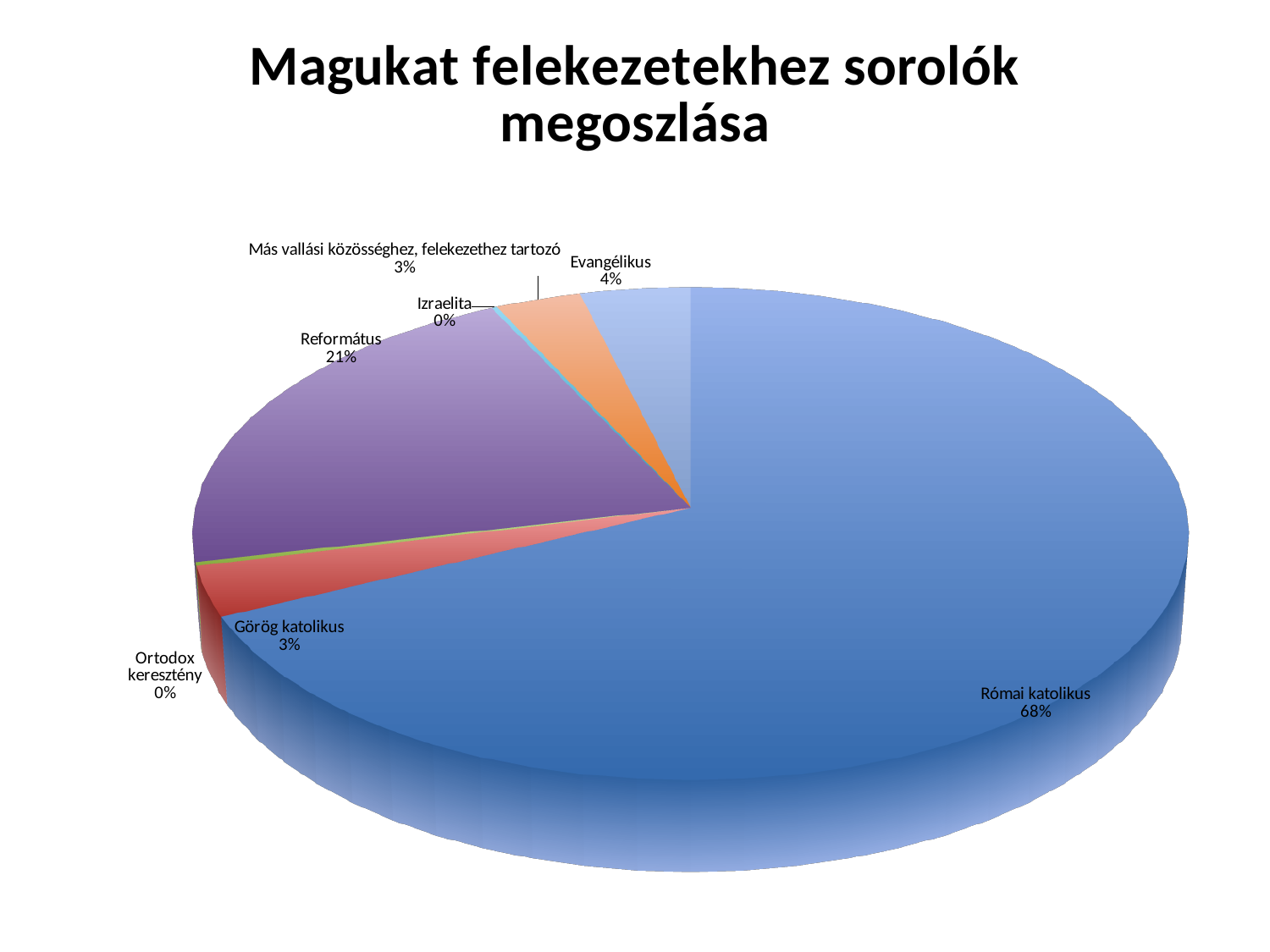
What share of the pie does Evangélikus have? 4% What is the difference in percentage points between Római katolikus and Református? 47 What share of the pie does Görög katolikus have? 3% What is the combined share of Református and Evangélikus? 25% What kind of chart is shown on the slide? Pie chart What share of the pie does Római katolikus have? 68% Which category has the largest slice of the pie? Római katolikus How many categories are shown in the pie chart? 7 What is the title of the chart? Magukat felekezetekhez sorolók megoszlása What percentage is shown for Izraelita? 0% Which is larger, the share for Evangélikus or the share for Görög katolikus? Evangélikus